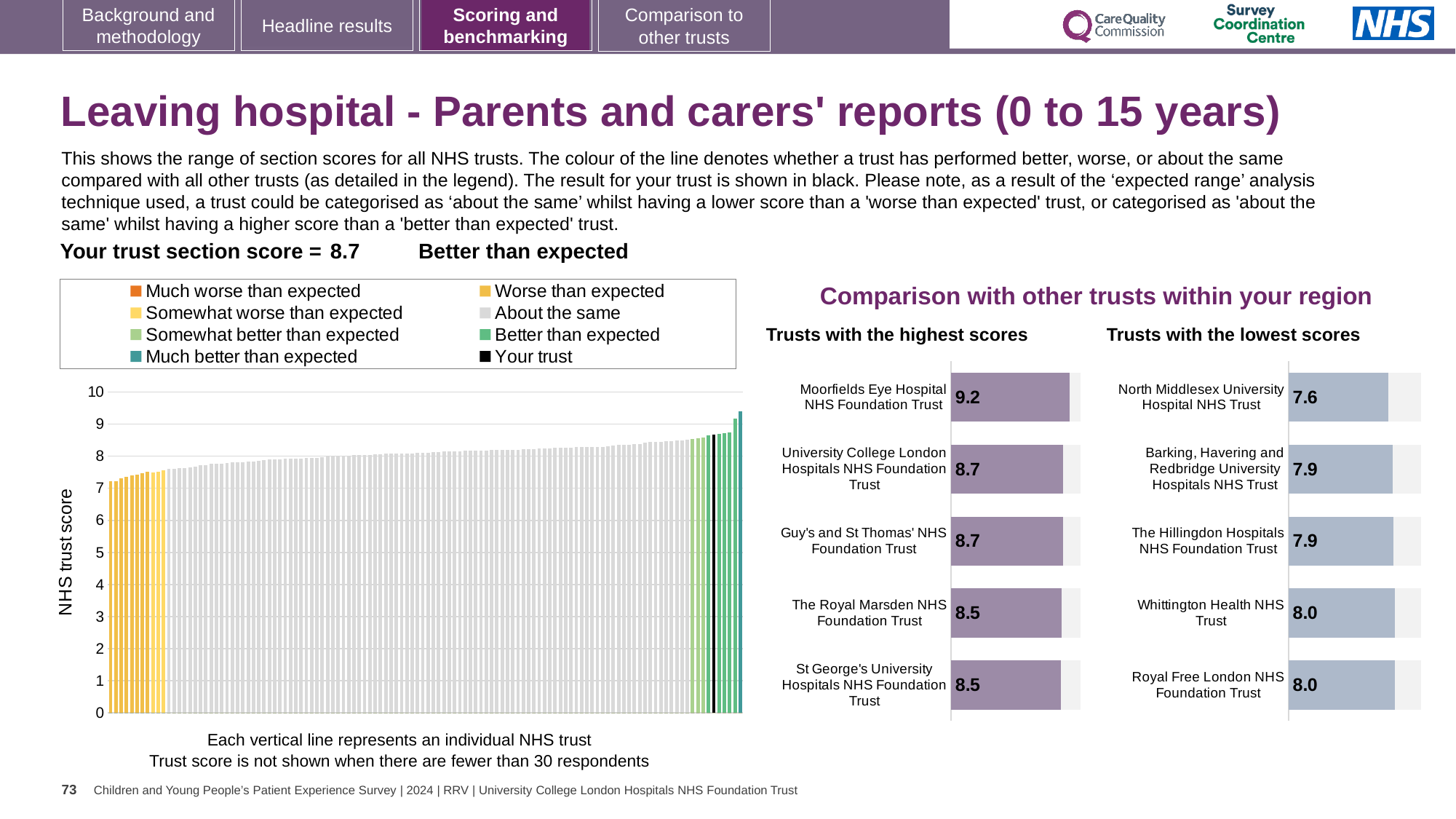
What kind of chart is the 'Trusts with the lowest scores' chart? Bar chart In the legend of the main chart on the left, what colour represents 'Your trust'? Black In the 'Trusts with the lowest scores' chart, what is the score for North Middlesex University Hospital NHS Trust? 7.6 In the 'Trusts with the highest scores' chart, what is the score for Moorfields Eye Hospital NHS Foundation Trust? 9.2 In the 'Trusts with the highest scores' chart, which trust has the highest score? Moorfields Eye Hospital NHS Foundation Trust In the 'Trusts with the lowest scores' chart, what is the score for The Hillingdon Hospitals NHS Foundation Trust? 7.9 In the 'Trusts with the lowest scores' chart, which trust has the lowest score? North Middlesex University Hospital NHS Trust In the main 'NHS trust score' chart on the left, is the value for the lowest-scoring trust greater or less than 5? greater In the 'Trusts with the highest scores' chart, which has the higher score: Moorfields Eye Hospital NHS Foundation Trust or Guy's and St Thomas' NHS Foundation Trust? Moorfields Eye Hospital NHS Foundation Trust In the 'Trusts with the lowest scores' chart, what is the difference between the scores of Whittington Health NHS Trust and North Middlesex University Hospital NHS Trust? 0.4 How many trusts are shown in the 'Trusts with the highest scores' chart? 5 In the 'Trusts with the highest scores' chart, what is the difference between the scores of Moorfields Eye Hospital NHS Foundation Trust and The Royal Marsden NHS Foundation Trust? 0.7